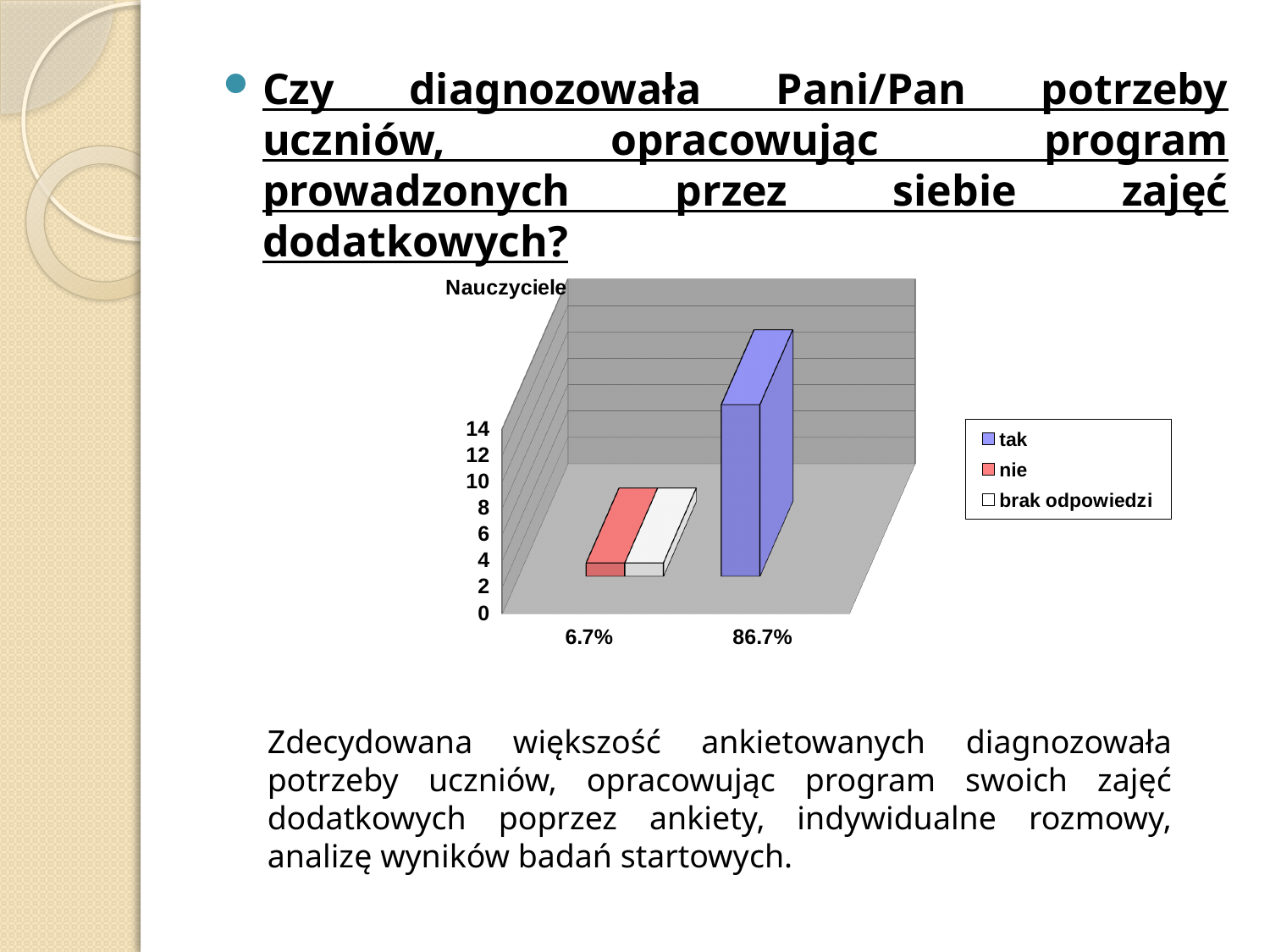
How many category labels are shown along the x axis of the chart? 2 Is the value for 'tak' greater or less than 10? greater Is the value for 'nie' greater or less than 4? less What is the highest value shown on the chart's vertical axis? 14 Which series is shown in blue in the chart legend? tak Which series has the tallest bar in the chart? tak What x-axis label appears under the blue 'tak' bar? 86.7% What kind of chart is shown on the slide? bar chart Is the value for 'brak odpowiedzi' greater or less than 6? less How many series does the chart legend list? 3 What is the title of the chart? Nauczyciele Which is larger in the chart, the bar for 'tak' or the bar for 'nie'? tak